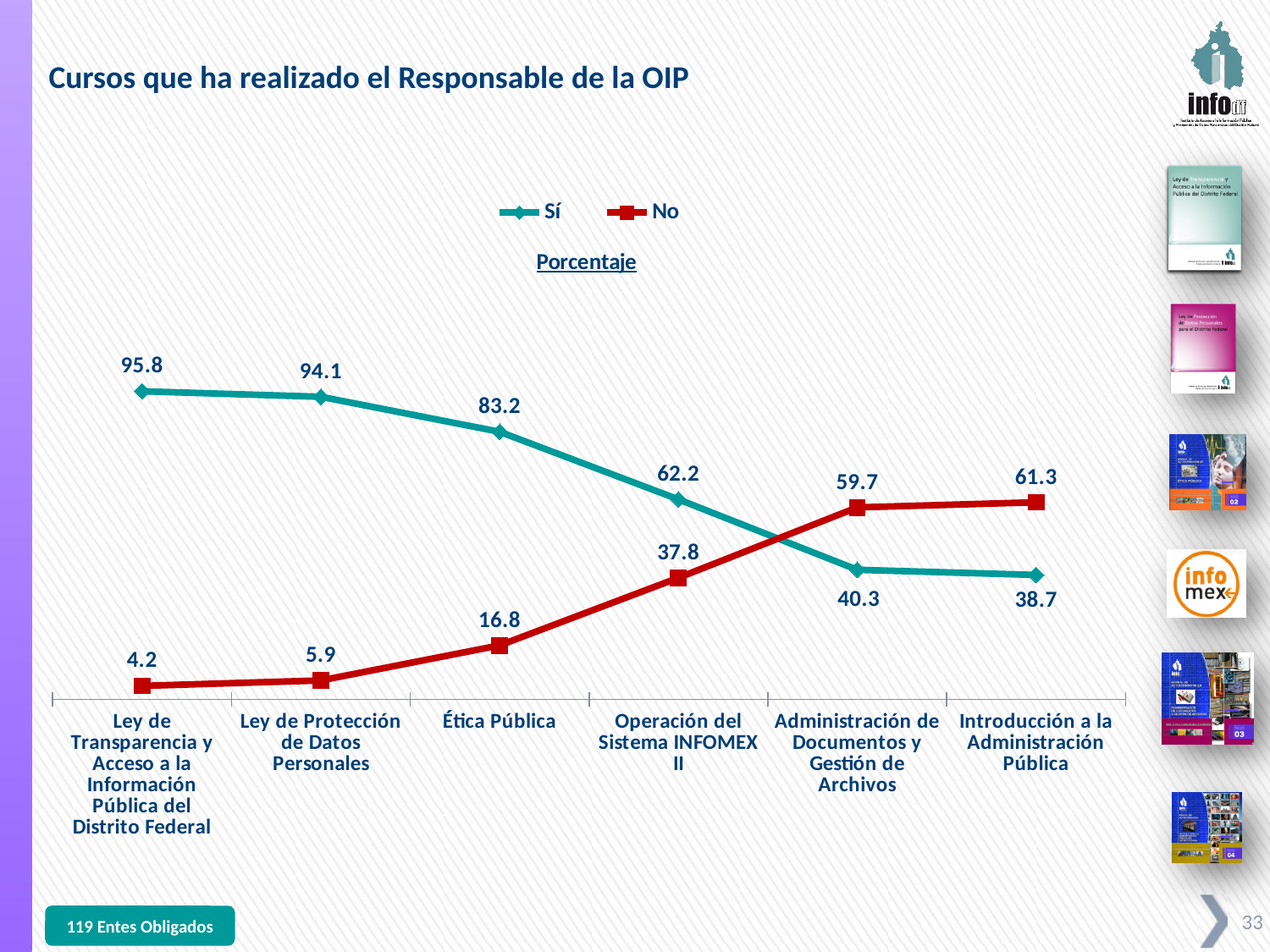
Which course has the lowest 'No' value? Ley de Transparencia y Acceso a la Información Pública del Distrito Federal How many series does the legend list? 2 How many courses are shown on the x axis? 6 Which is larger for Administración de Documentos y Gestión de Archivos, the 'Sí' value or the 'No' value? No What is the 'Sí' value for Ética Pública? 83.2 Does the 'Sí' series rise or fall from left to right along the x axis? Fall What is the title of the chart? Porcentaje What is the difference between the 'Sí' and 'No' values for Ética Pública? 66.4 What is the 'No' value for Operación del Sistema INFOMEX II? 37.8 Which course has the highest 'Sí' value? Ley de Transparencia y Acceso a la Información Pública del Distrito Federal What kind of chart is shown on the slide? Line chart What is the 'Sí' value for Introducción a la Administración Pública? 38.7